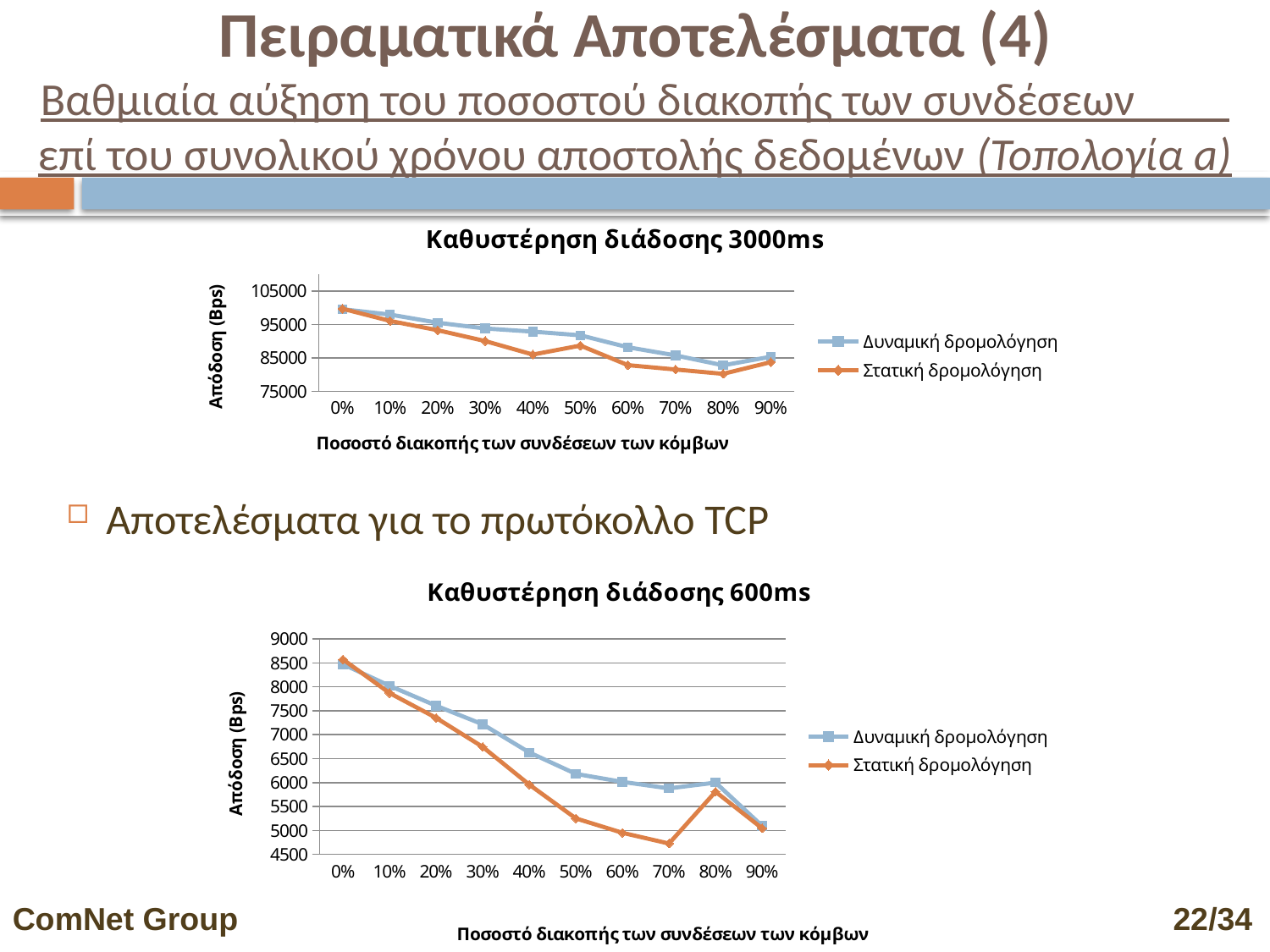
What is the y-axis label of the chart titled "Καθυστέρηση διάδοσης 600ms"? Απόδοση (Bps) How many categories are shown on the x axis of the chart titled "Καθυστέρηση διάδοσης 3000ms"? 10 In the chart titled "Καθυστέρηση διάδοσης 600ms", do the values for Δυναμική δρομολόγηση generally rise or fall from 0% to 70%? fall What is the x-axis label of the chart titled "Καθυστέρηση διάδοσης 3000ms"? Ποσοστό διακοπής των συνδέσεων των κόμβων How many series does the legend of the chart titled "Καθυστέρηση διάδοσης 600ms" list? 2 In the chart titled "Καθυστέρηση διάδοσης 600ms", which series has the larger value at 70%: Δυναμική δρομολόγηση or Στατική δρομολόγηση? Δυναμική δρομολόγηση What kind of chart is the chart titled "Καθυστέρηση διάδοσης 3000ms"? line chart In the chart titled "Καθυστέρηση διάδοσης 600ms", is the value for Δυναμική δρομολόγηση at 0% greater or less than 8000? greater In the chart titled "Καθυστέρηση διάδοσης 3000ms", is the value for Στατική δρομολόγηση at 70% greater or less than 85000? less In the chart titled "Καθυστέρηση διάδοσης 3000ms", which series has the larger value at 40%: Δυναμική δρομολόγηση or Στατική δρομολόγηση? Δυναμική δρομολόγηση In the chart titled "Καθυστέρηση διάδοσης 600ms", is the value for Στατική δρομολόγηση at 70% greater or less than 5000? less